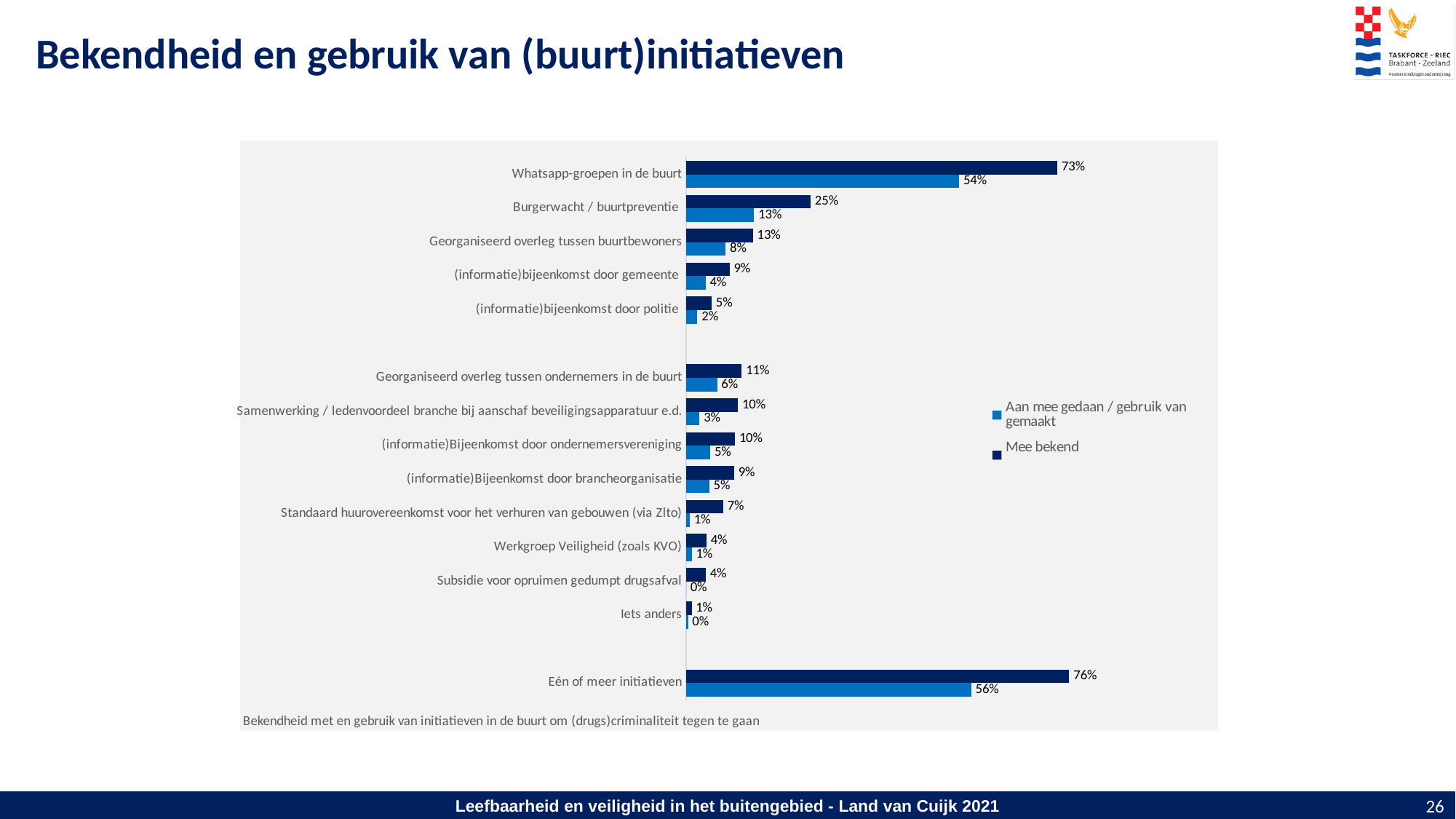
Which is larger: the 'Mee bekend' value for Burgerwacht / buurtpreventie or for Georganiseerd overleg tussen buurtbewoners? Burgerwacht / buurtpreventie Which series is shown in dark blue in the legend? Mee bekend What kind of chart is shown on the slide? bar chart What is the difference between the 'Mee bekend' and 'Aan mee gedaan / gebruik van gemaakt' values for Whatsapp-groepen in de buurt? 19% Which category has the lowest 'Mee bekend' value? Iets anders What is the 'Aan mee gedaan / gebruik van gemaakt' value for Subsidie voor opruimen gedumpt drugsafval? 0% What is the 'Aan mee gedaan / gebruik van gemaakt' value for Burgerwacht / buurtpreventie? 13% What is the 'Mee bekend' value for Eén of meer initiatieven? 76% Excluding Eén of meer initiatieven, which category has the highest 'Aan mee gedaan / gebruik van gemaakt' value? Whatsapp-groepen in de buurt How many categories are plotted in the chart? 14 How many series does the legend list? 2 What is the 'Mee bekend' value for Whatsapp-groepen in de buurt? 73%